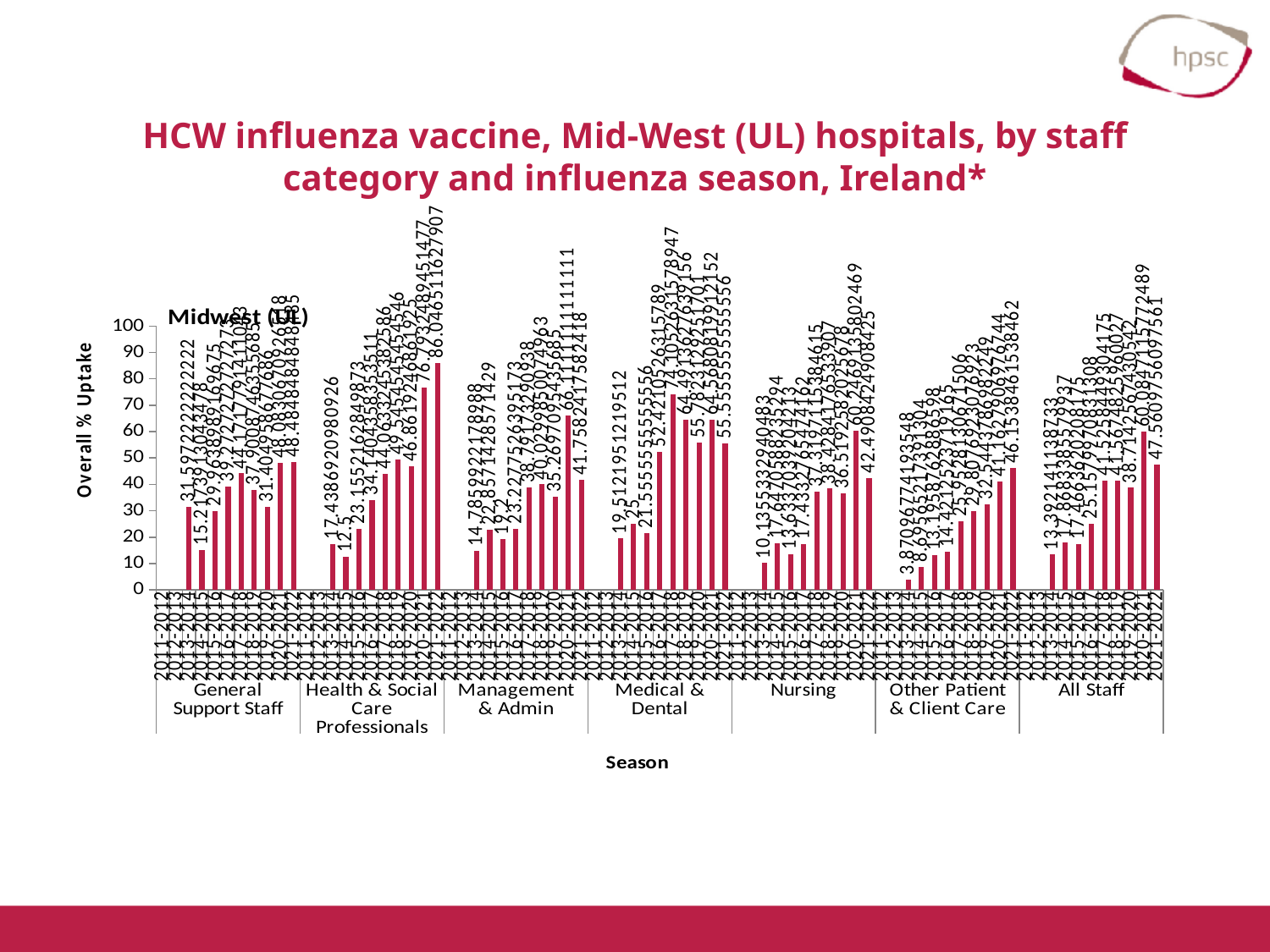
What is the label on the vertical axis of the chart? Overall % Uptake What kind of chart is shown on the slide? Bar chart Is the tallest bar in the Nursing group higher or lower than the tallest bar in the Medical & Dental group? lower How many staff category groups are shown along the x axis of the chart? 7 Which staff category group contains the shortest bar in the chart? Other Patient & Client Care Is the first (leftmost) bar in the Other Patient & Client Care group greater or less than 10? less Which staff category group contains the tallest bar in the chart? Health & Social Care Professionals What is the label on the horizontal axis of the chart? Season Is the tallest bar in the Health & Social Care Professionals group greater or less than 80? greater Is the tallest bar in the Medical & Dental group greater or less than 70? greater Within the Health & Social Care Professionals group, do the bars generally rise or fall from left to right across the seasons? rise